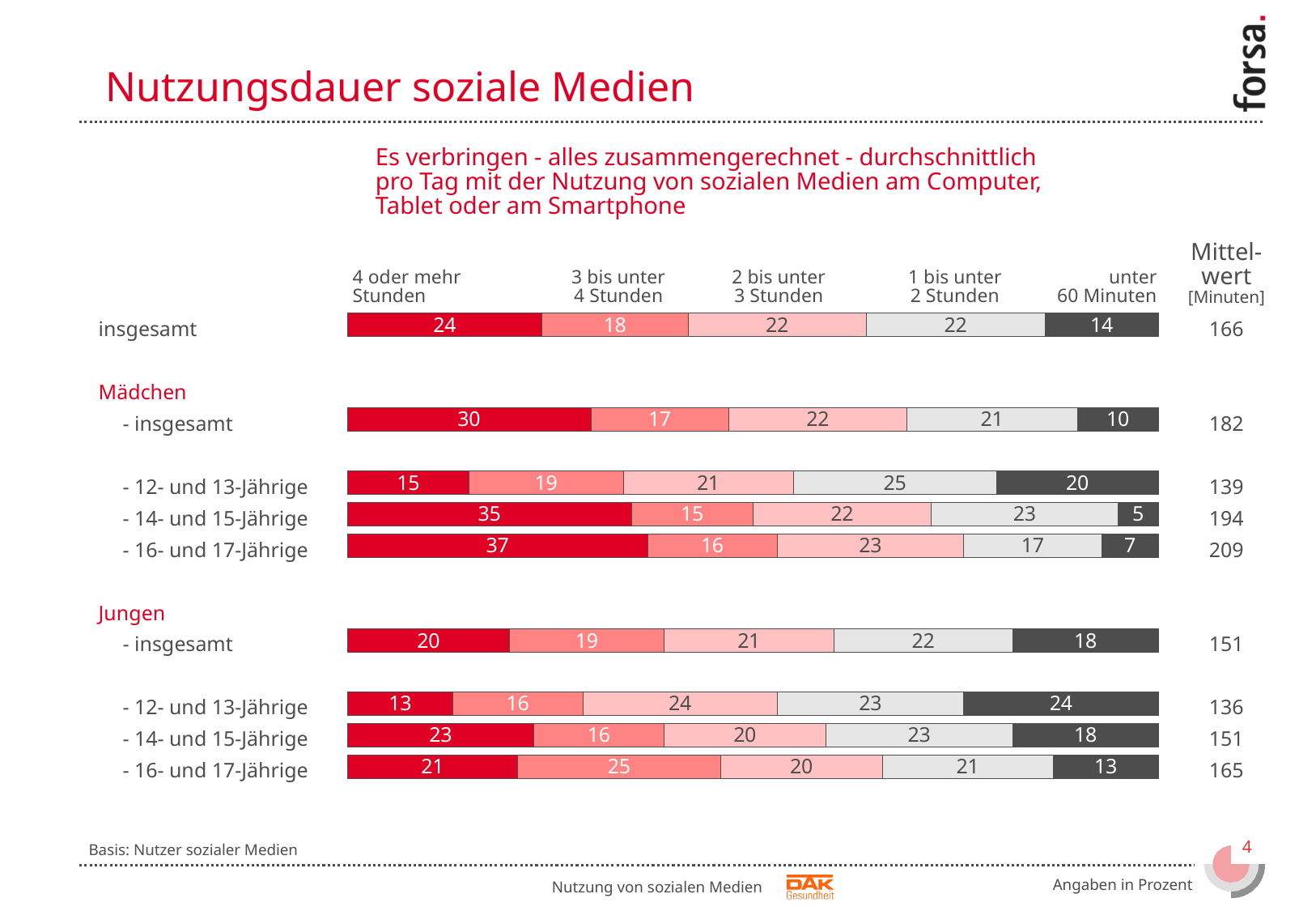
Which is larger: the 'unter 60 Minuten' share for Jungen 12- und 13-Jährige or for Mädchen 12- und 13-Jährige? Jungen 12- und 13-Jährige How many bars (groups) are shown in the chart? 9 Which group has the highest share in the '4 oder mehr Stunden' category? Mädchen 16- und 17-Jährige Which group has the lowest Mittelwert in minutes? Jungen 12- und 13-Jährige What is the Mittelwert in minutes for Mädchen 16- und 17-Jährige? 209 What is the difference between the '4 oder mehr Stunden' share of Mädchen insgesamt and Jungen insgesamt? 10 What is the value for '3 bis unter 4 Stunden' among Jungen 16- und 17-Jährige? 25 How many series (duration categories) does the chart show for each bar? 5 What percentage of all respondents (insgesamt) use social media 4 oder mehr Stunden per day? 24 Which group has the lowest share in the 'unter 60 Minuten' category? Mädchen 14- und 15-Jährige What is the difference in Mittelwert between Mädchen insgesamt and Jungen insgesamt? 31 What kind of chart is shown on the slide? stacked bar chart